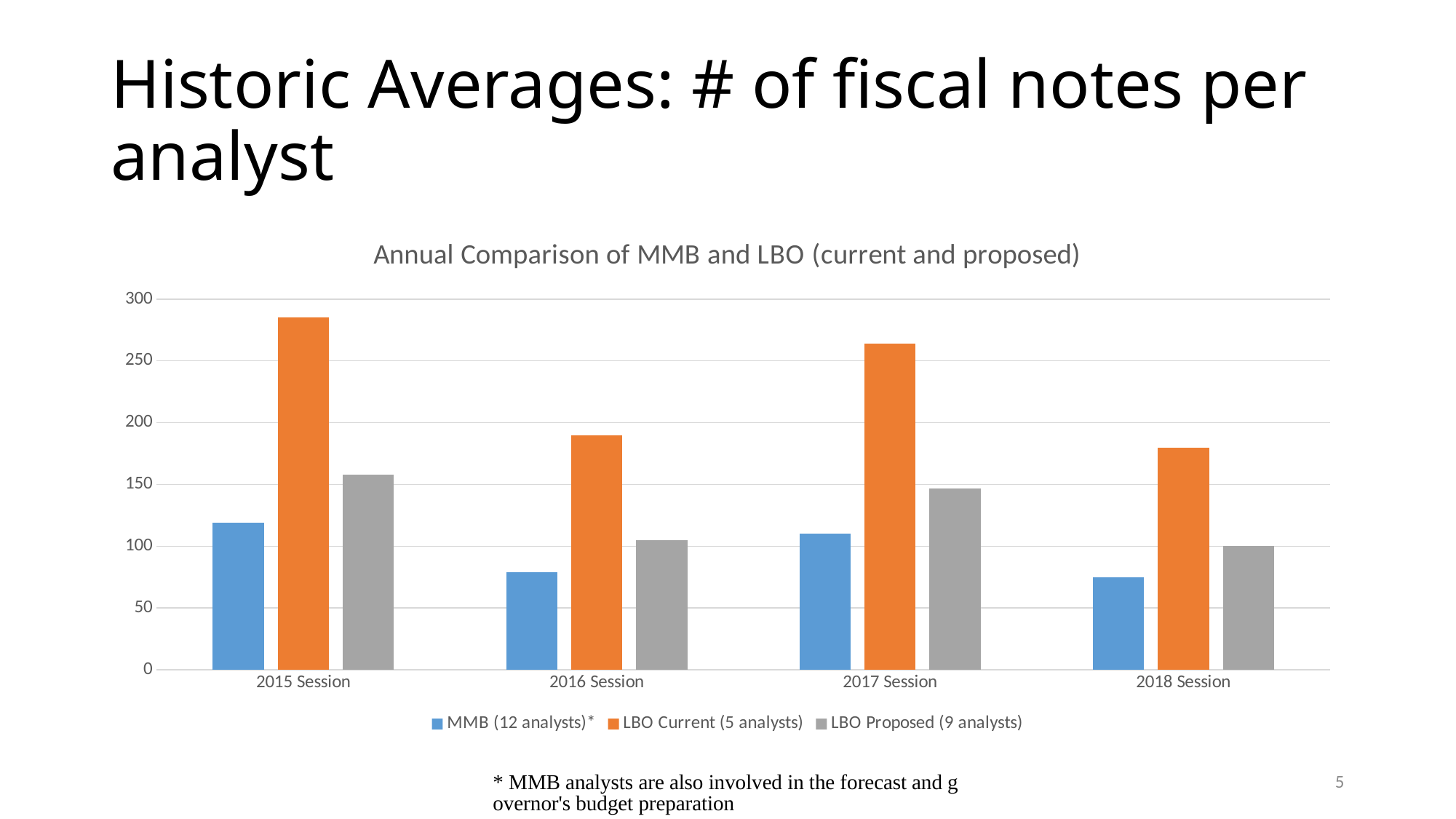
In which session is the LBO Current value highest? 2015 Session In the 2017 Session, which is larger: MMB or LBO Current? LBO Current Is the value for LBO Current in the 2015 Session greater or less than 250? greater How many series does the legend list? 3 What type of chart is shown on the slide? bar chart Does the MMB value rise or fall from the 2015 Session to the 2016 Session? fall Which series is shown in orange? LBO Current (5 analysts) Is the value for MMB in the 2016 Session greater or less than 100? less How many sessions are shown along the x axis? 4 Is the value for LBO Proposed in the 2017 Session greater or less than 100? greater What is the title of the chart? Annual Comparison of MMB and LBO (current and proposed)